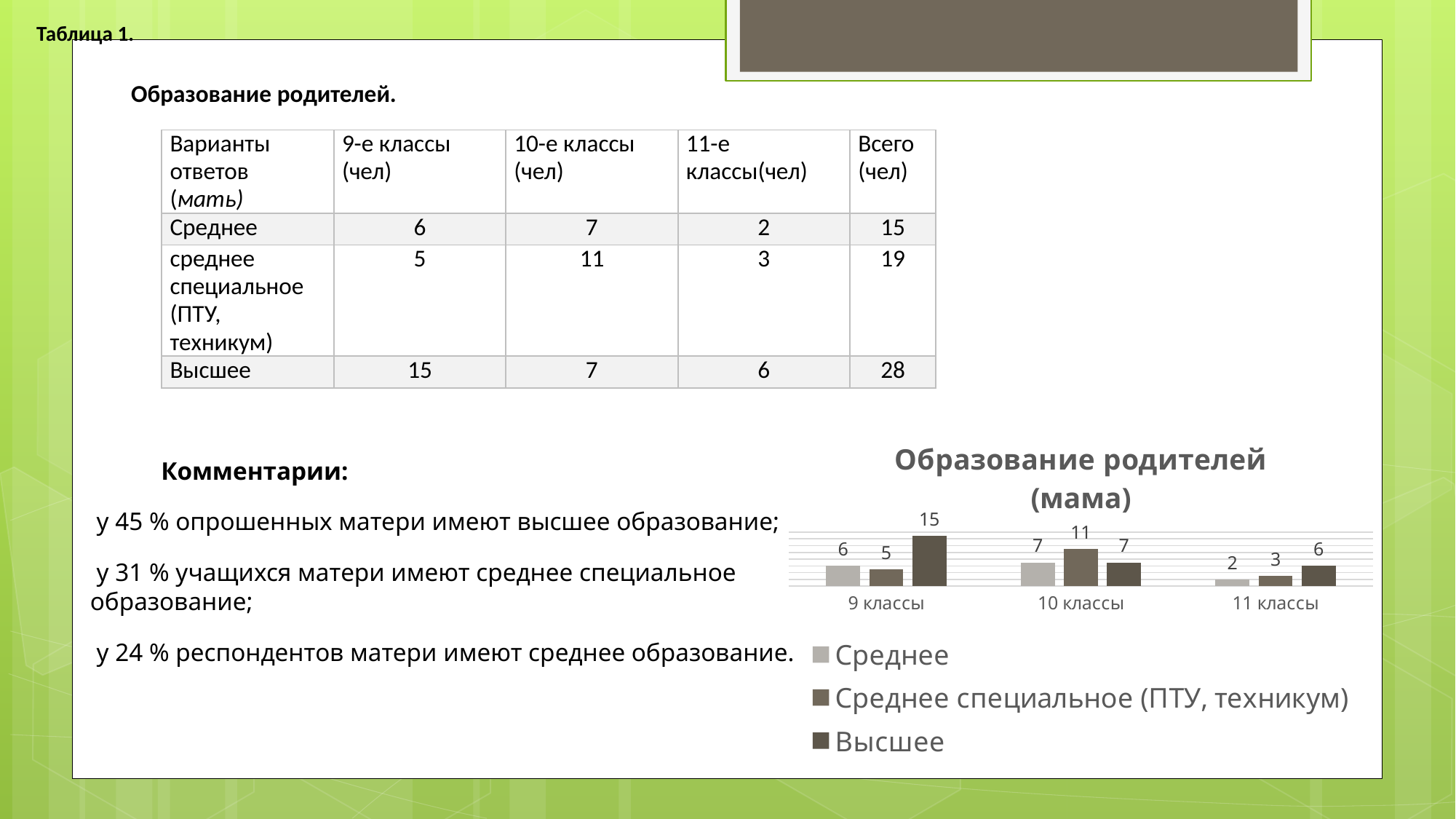
Which series has the highest value in the 9 классы group? Высшее Does the value for Среднее rise or fall from 9 классы to 11 классы? Fall What kind of chart is shown? Bar chart What is the value for Среднее in the 11 классы group? 2 What is the title of the chart? Образование родителей (мама) What is the difference between Высшее and Среднее in the 9 классы group? 9 How many class groups are shown on the x axis? 3 Which is larger in the 10 классы group: Среднее or Высшее? They are equal (7) What is the value for Среднее специальное (ПТУ, техникум) in the 10 классы group? 11 What is the value for Высшее in the 9 классы group? 15 How many series does the legend list? 3